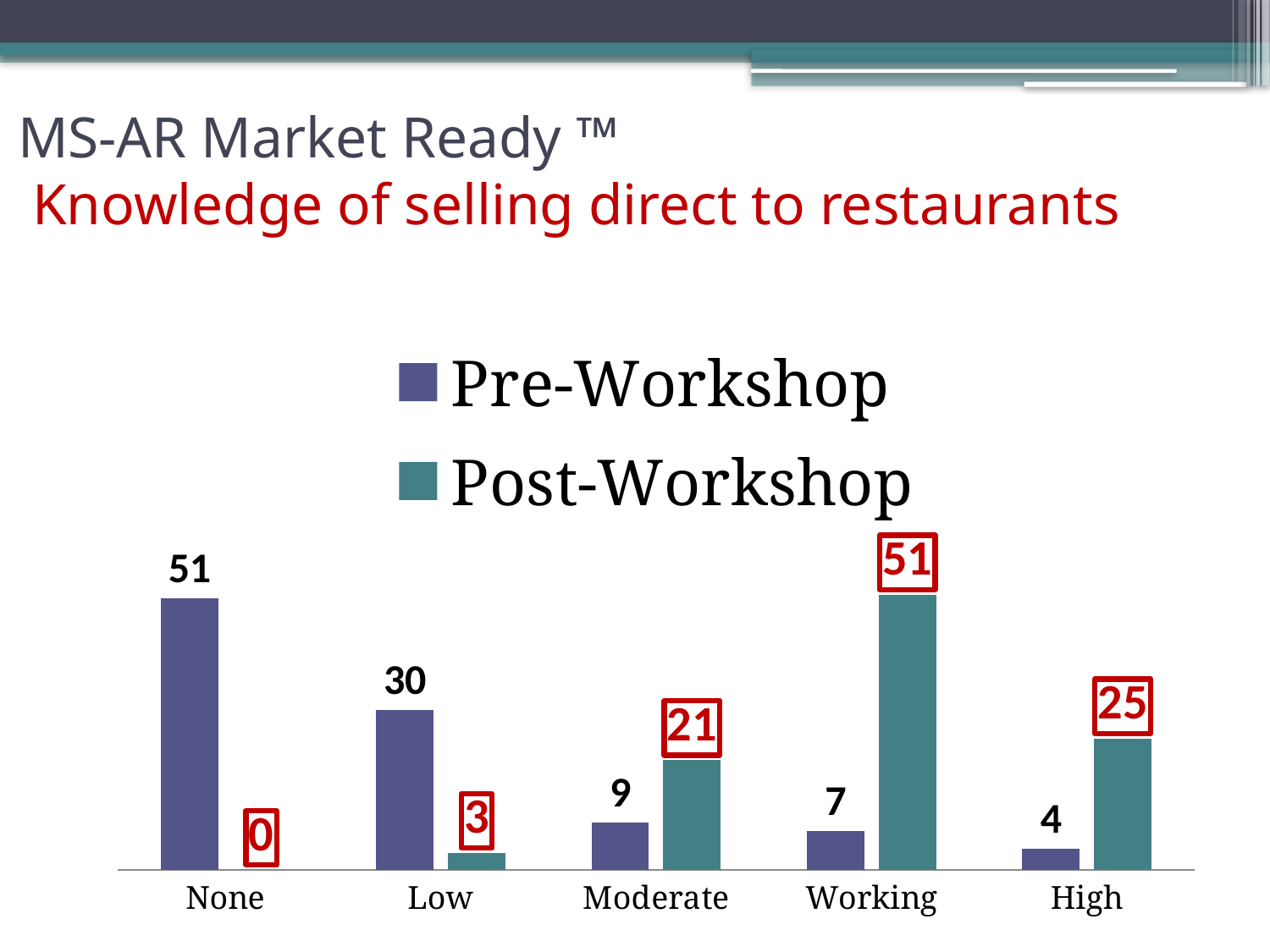
What is the Pre-Workshop value for the High category? 4 Which series is shown in teal in the legend? Post-Workshop What is the difference between the Post-Workshop and Pre-Workshop values for the Moderate category? 12 What kind of chart is shown on the slide? Bar chart Which is larger for the High category, the Pre-Workshop or the Post-Workshop value? Post-Workshop What is the Pre-Workshop value for the None category? 51 Which category has the highest Pre-Workshop value? None How many series does the legend list? 2 Which category has the lowest Post-Workshop value? None What is the Post-Workshop value for the Low category? 3 What is the Post-Workshop value for the Working category? 51 How many categories are shown on the x axis? 5